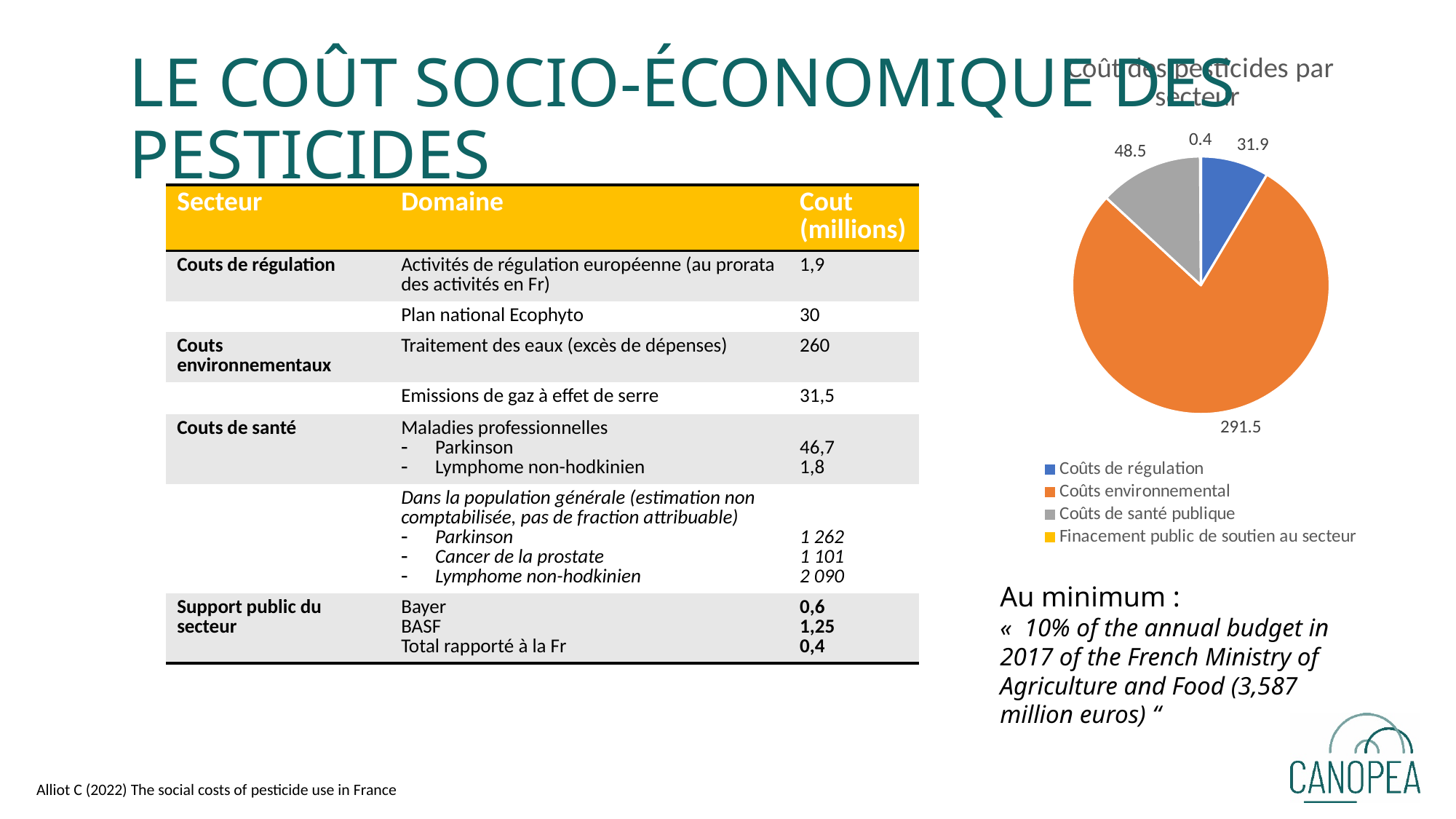
In the pie chart, which is larger: Coûts de santé publique or Coûts de régulation? Coûts de santé publique Which category has the smallest slice in the pie chart? Finacement public de soutien au secteur What colour is the Coûts environnemental slice in the pie chart? orange In the pie chart, what is the difference between Coûts de santé publique and Coûts de régulation? 16.6 Which category has the largest slice in the pie chart? Coûts environnemental In the pie chart, what is the difference between Coûts environnemental and Coûts de santé publique? 243 How many categories does the pie chart's legend list? 4 In the pie chart, what is the value for Finacement public de soutien au secteur? 0.4 In the pie chart, what is the value for Coûts environnemental? 291.5 What kind of chart is shown on the slide? pie chart In the pie chart, what is the value for Coûts de santé publique? 48.5 In the pie chart, what is the value for Coûts de régulation? 31.9